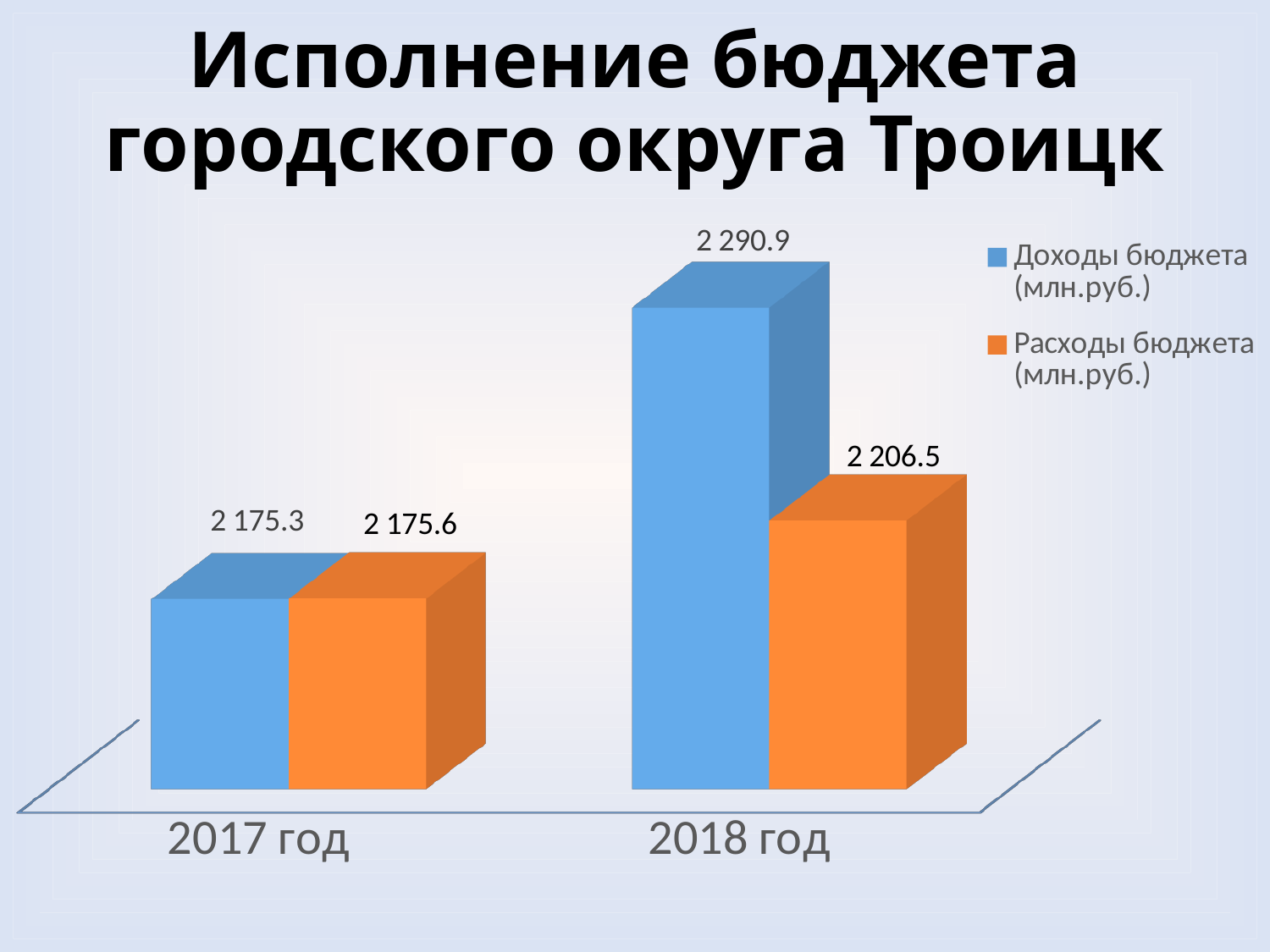
In 2018 год, which is larger: Доходы бюджета or Расходы бюджета? Доходы бюджета Which year has the lower value for Расходы бюджета? 2017 год What is the value of Расходы бюджета for 2018 год? 2 206.5 Do the values for Расходы бюджета rise or fall from 2017 год to 2018 год? Rise What is the value of Доходы бюджета for 2018 год? 2 290.9 How many series does the legend list? 2 Which year has the higher value for Доходы бюджета? 2018 год What is the value of Доходы бюджета for 2017 год? 2 175.3 What kind of chart is shown on the slide? Bar chart By how much did Доходы бюджета increase from 2017 год to 2018 год? 115.6 What is the difference between Доходы бюджета and Расходы бюджета in 2018 год? 84.4 What is the value of Расходы бюджета for 2017 год? 2 175.6